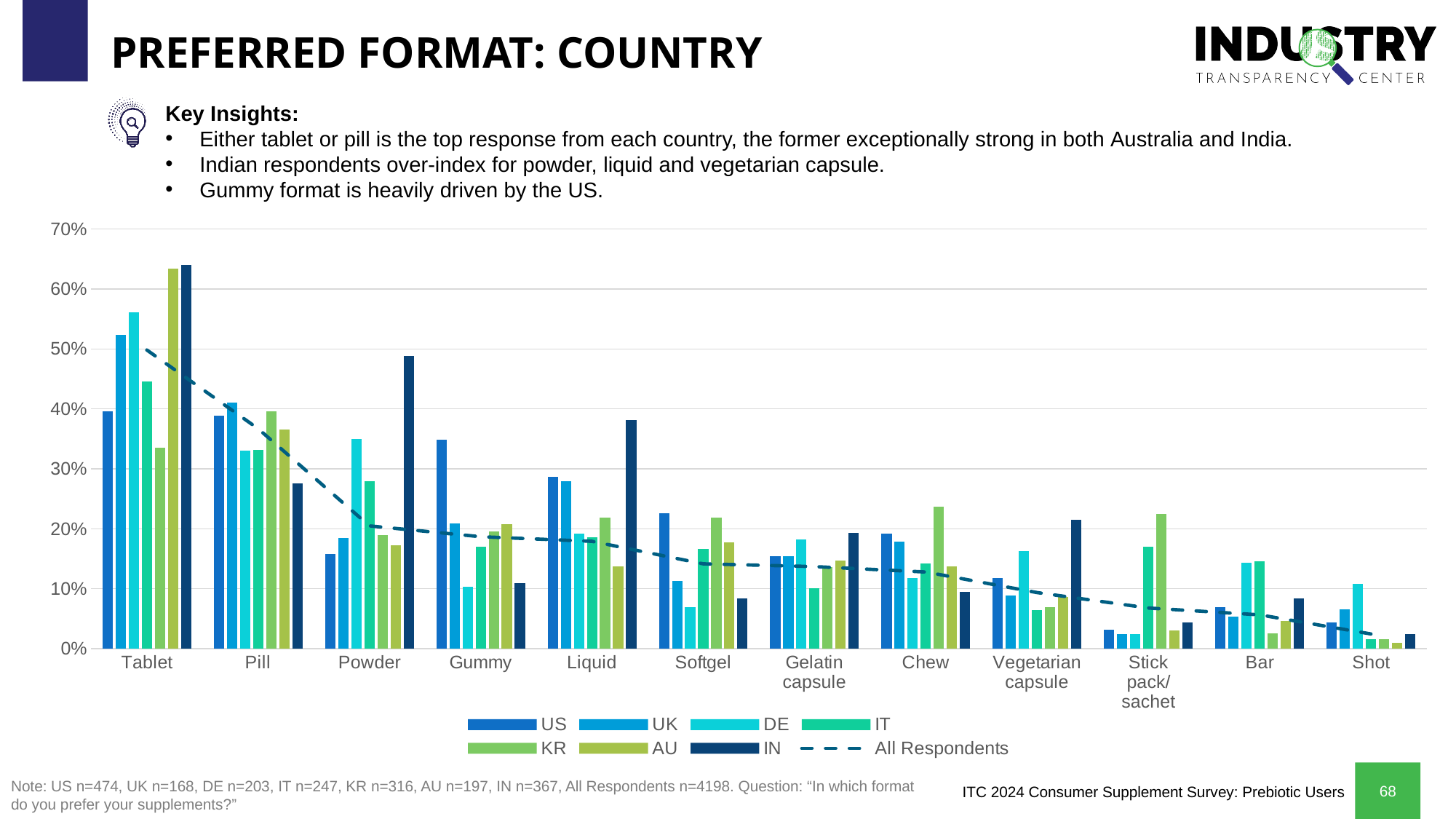
How many entries does the legend list? 8 How many format categories are shown along the x axis? 12 For Gummy, which is larger: the value for US or the value for IN? US Is the value for IN for Tablet greater or less than 60%? greater Which country has the highest value for Stick pack/sachet? KR Which country has the highest value for Powder? IN Is the value for IN for Pill greater or less than 30%? less Which country has the highest value for Gummy? US Does the All Respondents dashed line rise or fall from Tablet to Shot? Fall Is the value for IN for Liquid greater or less than 30%? greater What kind of chart is shown on the slide? Combination bar and line chart (clustered bars with a dashed line) Which country has the lowest value for Tablet? KR